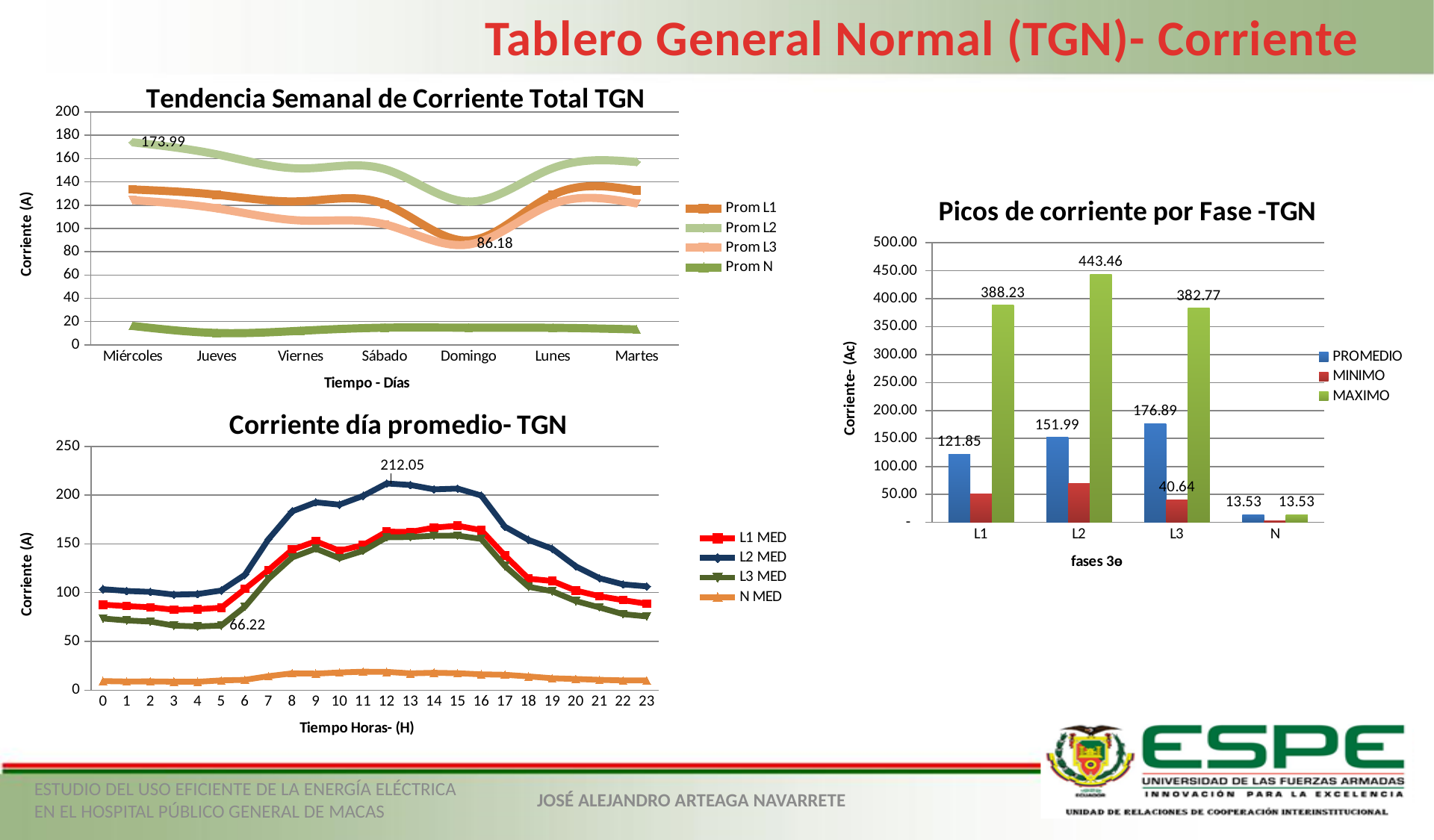
How many days are shown on the x axis of the 'Tendencia Semanal de Corriente Total TGN' chart? 7 In the 'Picos de corriente por Fase -TGN' chart, what is the PROMEDIO value for L3? 176.89 In the 'Corriente día promedio- TGN' chart, what is the labeled peak value of L2 MED? 212.05 In the 'Picos de corriente por Fase -TGN' chart, is the MINIMO value for L2 greater or less than 50.00? greater In the 'Tendencia Semanal de Corriente Total TGN' chart, what is the labeled value for Prom L2 on Miércoles? 173.99 In the 'Picos de corriente por Fase -TGN' chart, which phase has the highest MAXIMO value? L2 In the 'Picos de corriente por Fase -TGN' chart, which is larger, the PROMEDIO for L2 or the PROMEDIO for L3? L3 How many series does the legend of the 'Picos de corriente por Fase -TGN' chart list? 3 In the 'Picos de corriente por Fase -TGN' chart, what is the MAXIMO value for L2? 443.46 In the 'Picos de corriente por Fase -TGN' chart, what is the MINIMO value for L3? 40.64 What kind of chart is 'Picos de corriente por Fase -TGN'? bar chart In the 'Picos de corriente por Fase -TGN' chart, what is the difference between the MAXIMO values for L2 and L1? 55.23